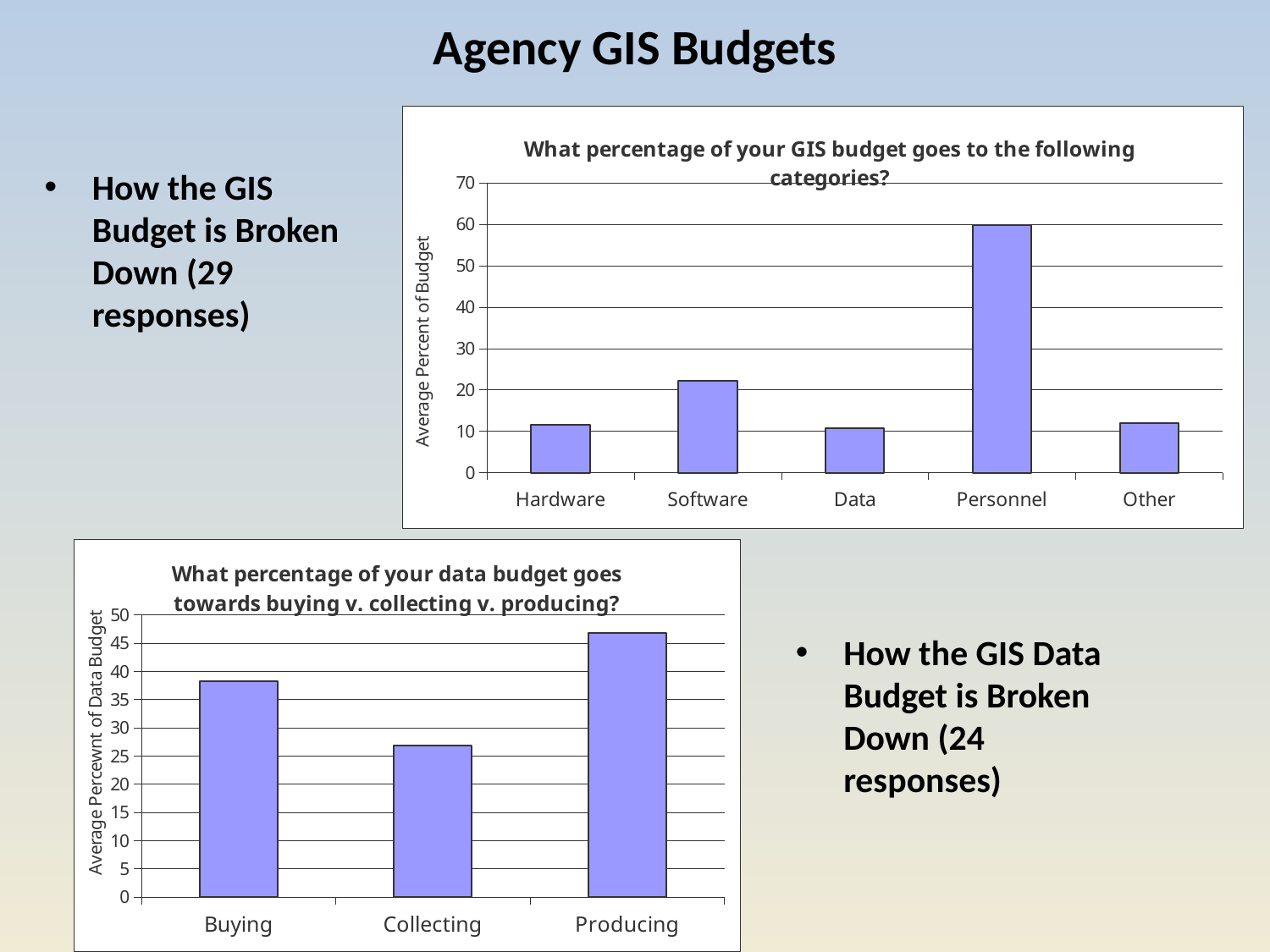
In the top chart, 'What percentage of your GIS budget goes to the following categories?', which category has the highest value? Personnel What kind of chart is the top chart, 'What percentage of your GIS budget goes to the following categories?' bar chart In the top chart, 'What percentage of your GIS budget goes to the following categories?', is the value for Software greater or less than 30? less How many categories are shown in the top chart, 'What percentage of your GIS budget goes to the following categories?' 5 In the bottom chart, 'What percentage of your data budget goes towards buying v. collecting v. producing?', which category has the lowest value? Collecting In the bottom chart, 'What percentage of your data budget goes towards buying v. collecting v. producing?', is the value for Collecting greater or less than 30? less What is the y-axis label of the bottom chart, 'What percentage of your data budget goes towards buying v. collecting v. producing?' Average Percewnt of Data Budget In the bottom chart, 'What percentage of your data budget goes towards buying v. collecting v. producing?', which category has the highest value? Producing In the top chart, 'What percentage of your GIS budget goes to the following categories?', is the value for Hardware greater or less than 20? less In the top chart, 'What percentage of your GIS budget goes to the following categories?', which is larger, Software or Data? Software